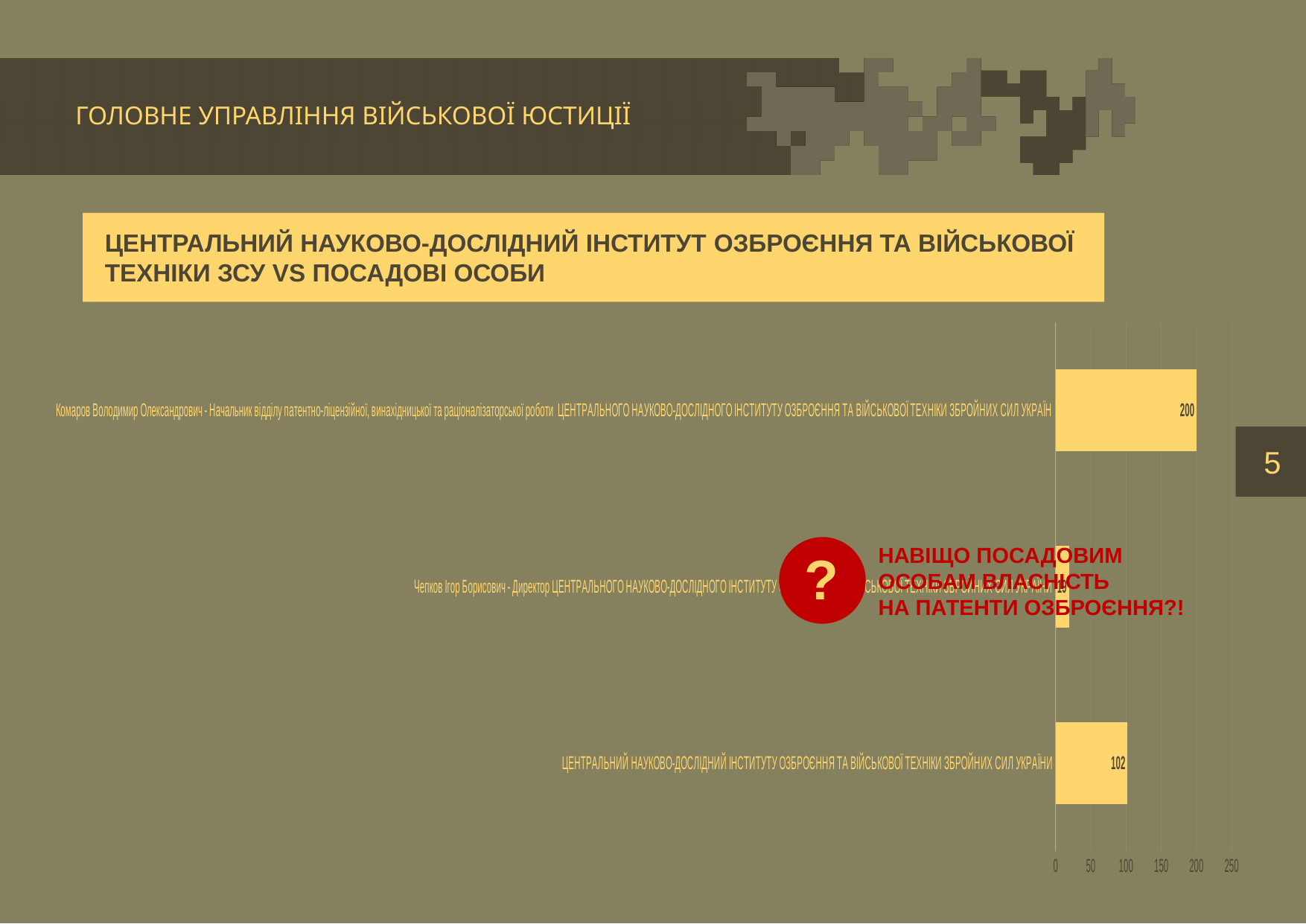
Which category has the highest value in the chart? Комаров Володимир Олександрович What value is shown for Комаров Володимир Олександрович? 200 What is the title shown in the yellow box above the chart? ЦЕНТРАЛЬНИЙ НАУКОВО-ДОСЛІДНИЙ ІНСТИТУТ ОЗБРОЄННЯ ТА ВІЙСЬКОВОЇ ТЕХНІКИ ЗСУ VS ПОСАДОВІ ОСОБИ What kind of chart is shown on the slide? Bar chart What is the difference between the value for Комаров Володимир Олександрович and the value for the institute (ЦЕНТРАЛЬНИЙ НАУКОВО-ДОСЛІДНИЙ ІНСТИТУТ)? 98 What is the highest tick value shown on the chart's value axis? 250 Which category has the lowest value in the chart? Чепков Ігор Борисович How many bars are plotted in the chart? 3 What value is shown for the bar labelled ЦЕНТРАЛЬНИЙ НАУКОВО-ДОСЛІДНИЙ ІНСТИТУТ ОЗБРОЄННЯ ТА ВІЙСЬКОВОЇ ТЕХНІКИ ЗБРОЙНИХ СИЛ УКРАЇНИ? 102 Which is larger: the value for Комаров Володимир Олександрович or the value for the institute (ЦЕНТРАЛЬНИЙ НАУКОВО-ДОСЛІДНИЙ ІНСТИТУТ)? Комаров Володимир Олександрович Is the value for Чепков Ігор Борисович greater or less than 50? less Is the value for Комаров Володимир Олександрович greater or less than 150? greater